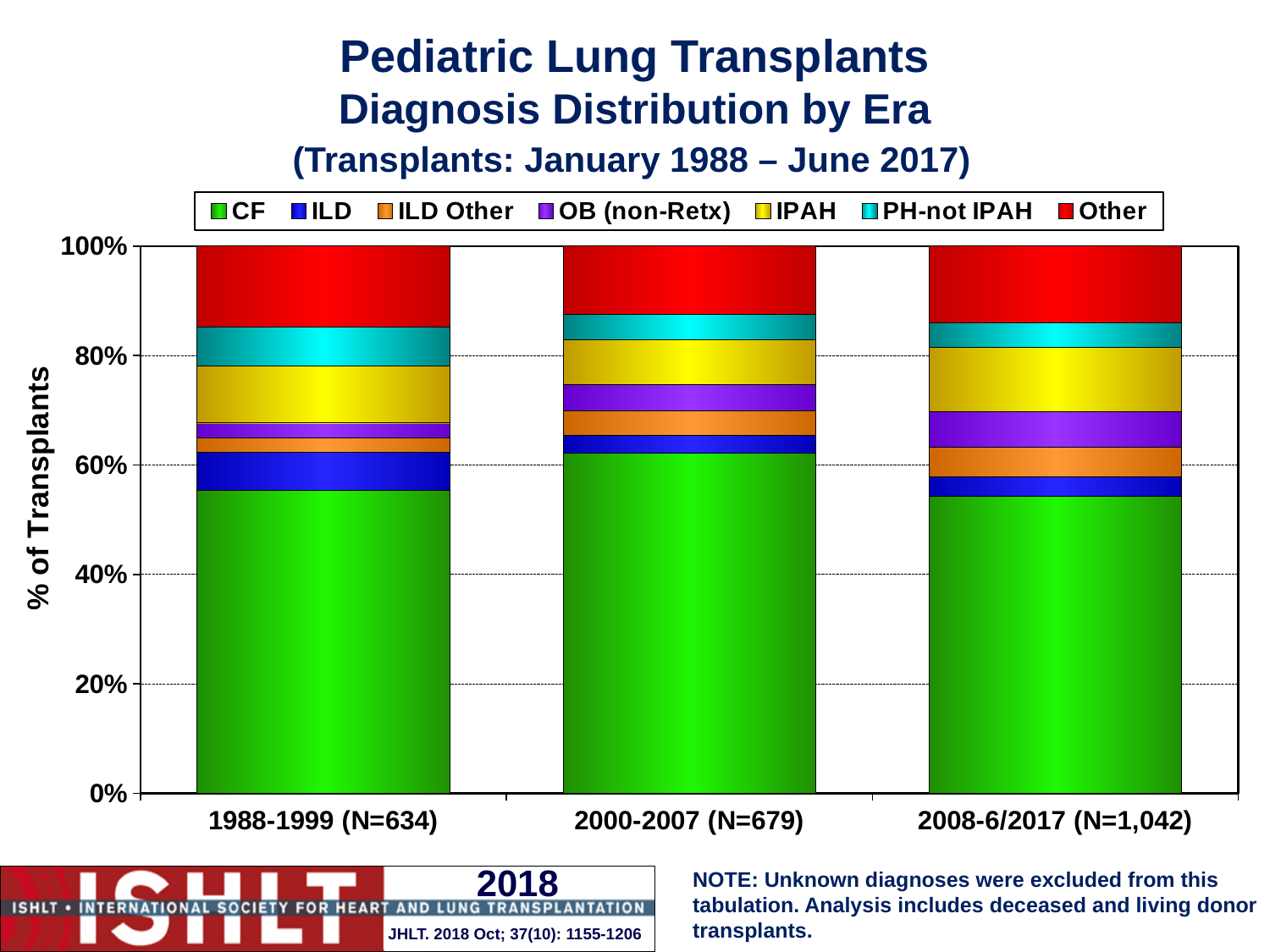
What is the number of transplants (N) for the 2000-2007 era? 679 What is the number of transplants (N) for the 2008-6/2017 era? 1,042 How many eras (categories) are shown on the x axis? 3 What is the number of transplants (N) for the 1988-1999 era? 634 Is the CF share of transplants in the 2000-2007 era greater or less than 60%? greater Is the CF share of transplants in the 1988-1999 era greater or less than 60%? less Is the CF share of transplants in the 2008-6/2017 era greater or less than 60%? less What kind of chart is shown on the slide? Stacked bar chart Is the CF share larger in the 2000-2007 era or the 1988-1999 era? 2000-2007 How many diagnosis series does the legend list? 7 Which era has the highest CF share of transplants? 2000-2007 What is the label on the y axis? % of Transplants